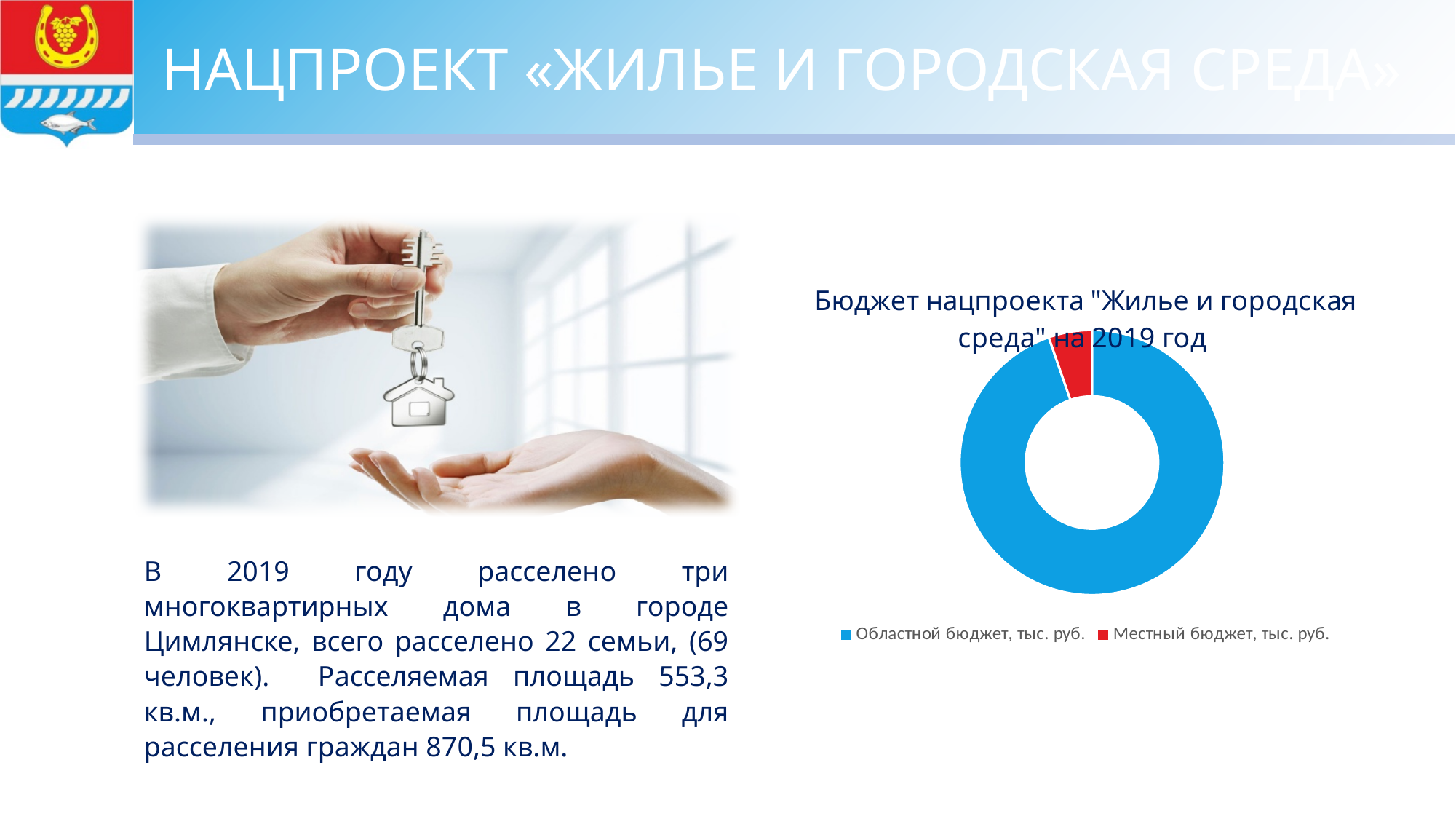
What kind of chart is shown on the slide? doughnut chart How many entries does the chart legend list? 2 What colour represents Местный бюджет in the chart? red What is the title of the chart? Бюджет нацпроекта "Жилье и городская среда" на 2019 год Which is larger in the chart, Областной бюджет or Местный бюджет? Областной бюджет Which budget source makes up the largest share of the chart? Областной бюджет, тыс. руб. How many slices does the doughnut chart have? 2 Which budget source makes up the smallest share of the chart? Местный бюджет, тыс. руб.